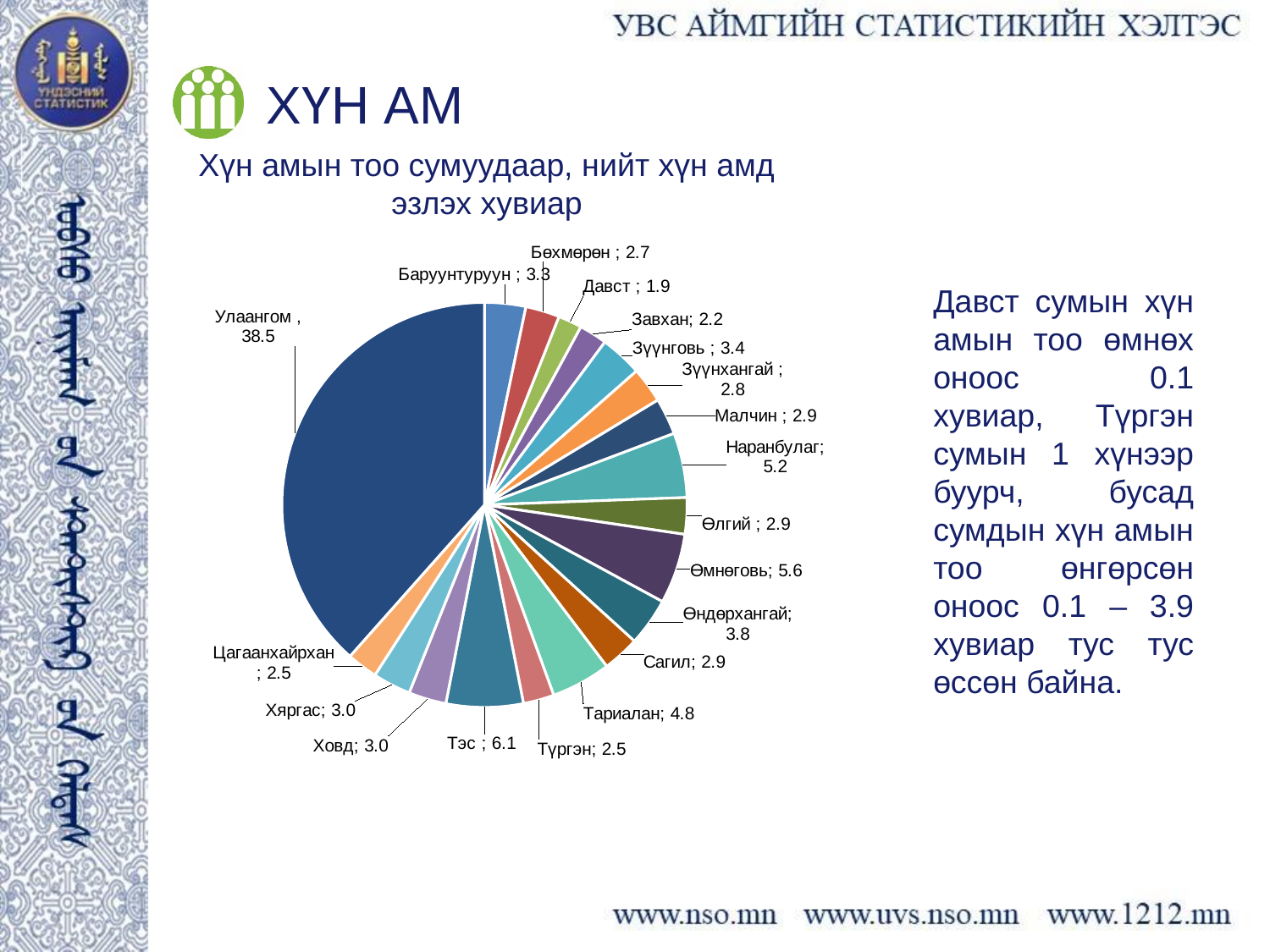
What is the value shown for Давст? 1.9 What is the difference between the values for Улаангом and Тэс? 32.4 Which sum has the smallest slice of the pie? Давст What is the value shown for Наранбулаг? 5.2 How many sums (slices) are shown in the pie chart? 19 What kind of chart is shown on the slide? pie chart Which is larger, the value for Тариалан or the value for Зүүнговь? Тариалан Which sum has the largest slice of the pie? Улаангом What is the title of the chart? Хүн амын тоо сумуудаар, нийт хүн амд эзлэх хувиар What is the value shown for Улаангом? 38.5 What is the difference between the values for Өмнөговь and Өндөрхангай? 1.8 What is the value shown for Тэс? 6.1